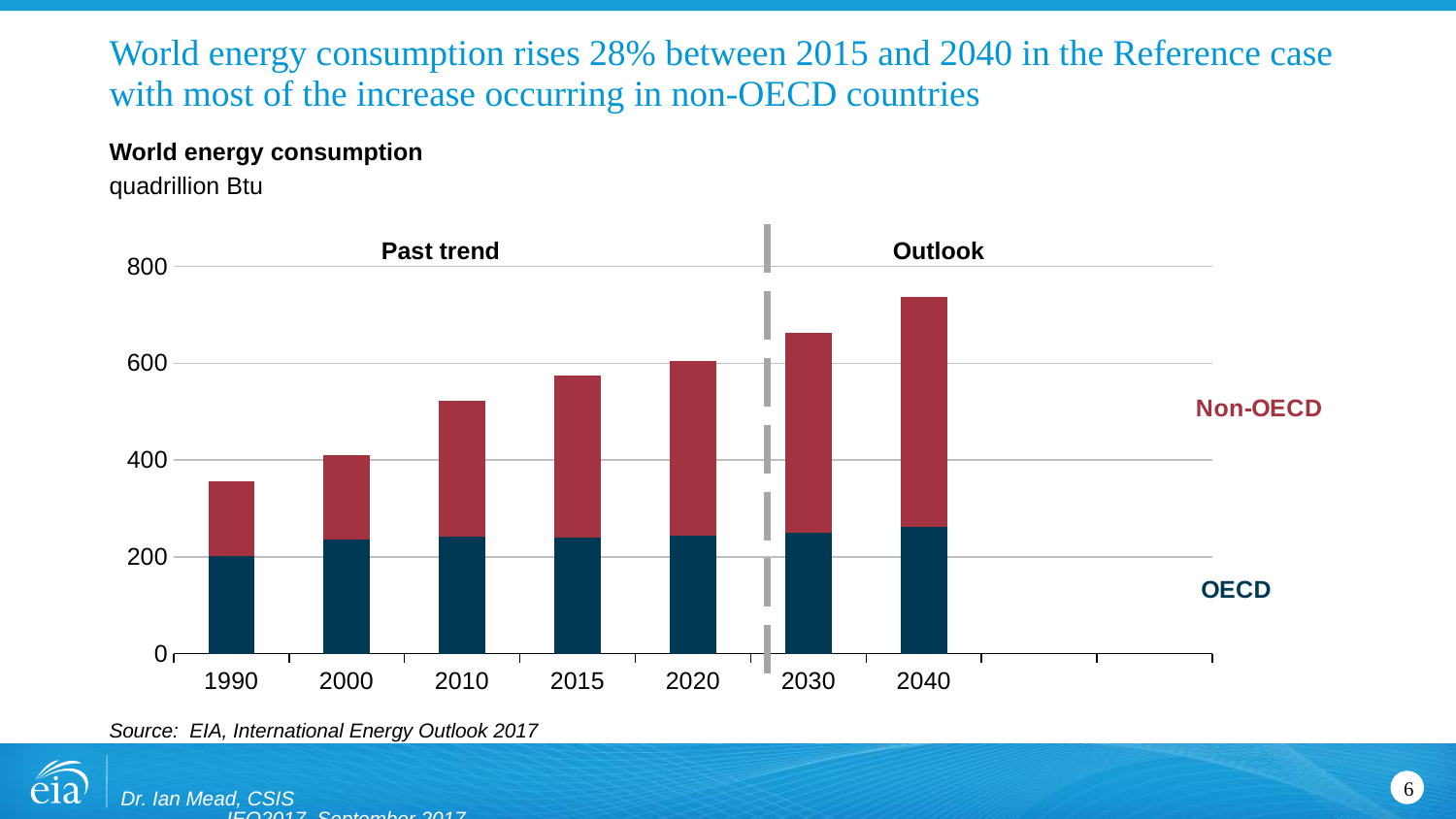
What kind of chart is shown on the slide? Stacked bar chart Which year has the lowest total world energy consumption in the chart? 1990 Is the total value for 2010 greater or less than 400? greater Is the total value for 1990 greater or less than 400? less What unit is the chart's y axis measured in? quadrillion Btu Do the total bar heights rise or fall from 1990 to 2040? Rise Is the total value for 2040 greater or less than 600? greater Which year has the highest total world energy consumption in the chart? 2040 How many series does the chart show? 2 Which series is larger in 2040, OECD or Non-OECD? Non-OECD How many years are shown along the x axis of the chart? 7